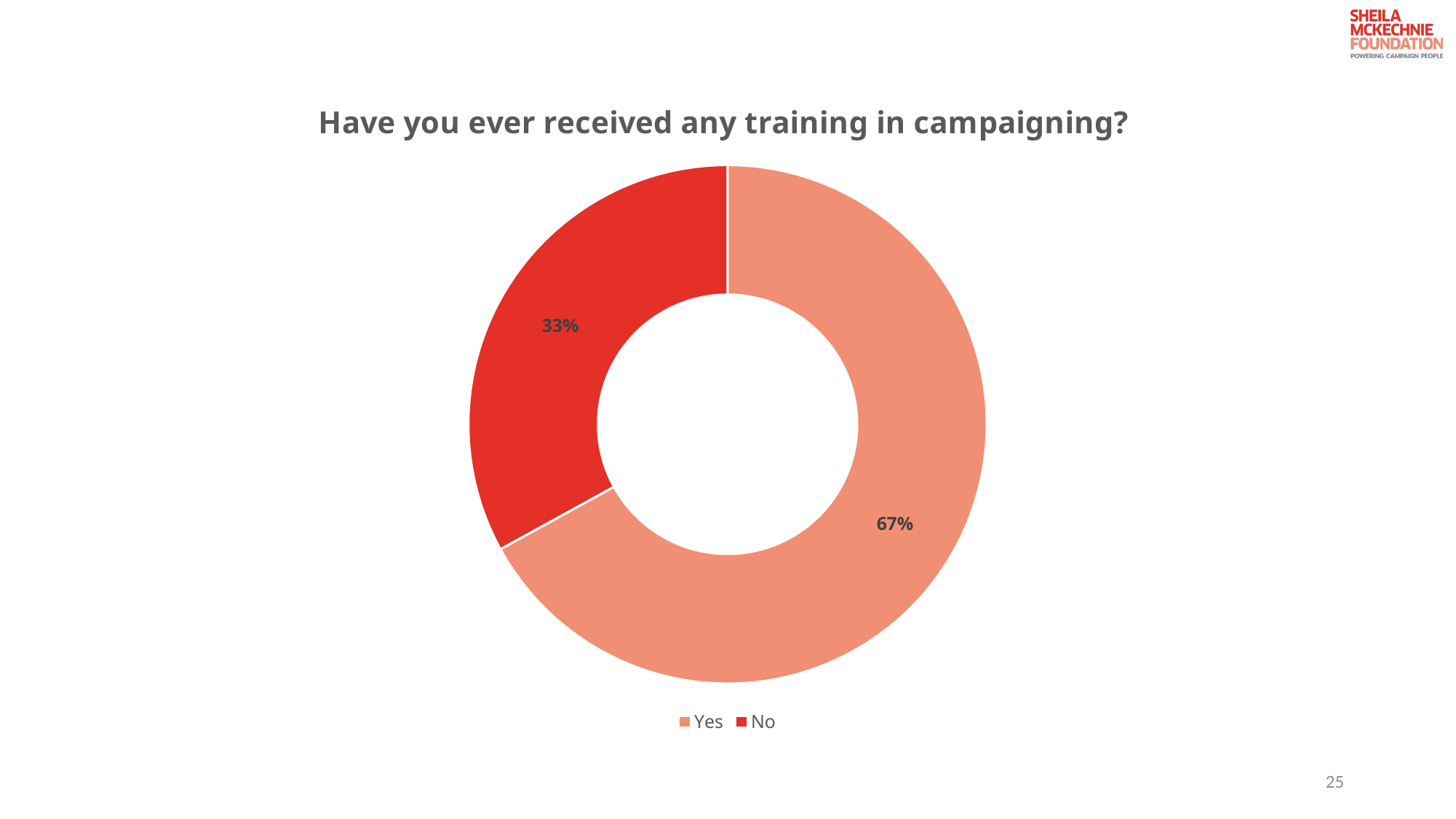
How many categories does the chart show? 2 What kind of chart is shown on the slide? Doughnut (pie) chart Which colour represents the No response in the chart? Red How many entries does the legend list? 2 Which response has the smallest share of the chart? No What percentage of respondents answered Yes? 67% What is the title of the chart? Have you ever received any training in campaigning? What share of the chart does the Yes slice represent? 67% Which response has the largest share of the chart? Yes What percentage of respondents answered No? 33% Which is larger, the share for Yes or the share for No? Yes What is the difference in percentage points between the Yes and No shares? 34